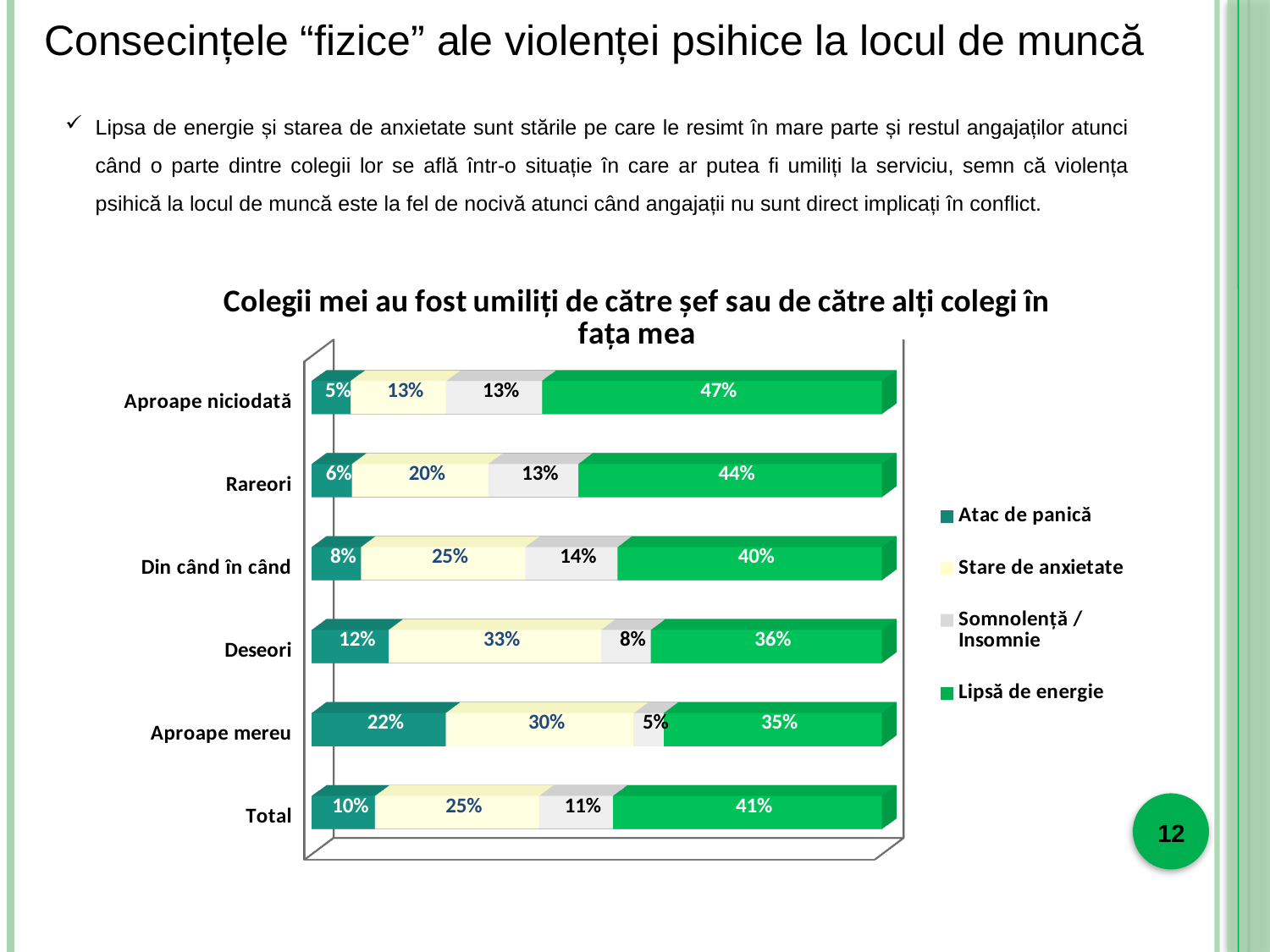
What is the total of the stacked bar for "Deseori"? 89% Which category has the lowest value for "Lipsă de energie"? Aproape mereu What is the difference between the "Lipsă de energie" values for "Aproape niciodată" and "Aproape mereu"? 12% What is the value for "Stare de anxietate" in the "Deseori" category? 33% Which category has the highest value for "Atac de panică"? Aproape mereu What is the value for "Lipsă de energie" in the "Aproape niciodată" category? 47% Which is larger: "Stare de anxietate" for "Rareori" or for "Din când în când"? Din când în când How many series does the legend list? 4 What is the value for "Atac de panică" in the "Aproape mereu" category? 22% What kind of chart is shown on the slide? Stacked bar chart How many categories are shown on the chart? 6 What is the value for "Somnolență / Insomnie" in the "Total" category? 11%